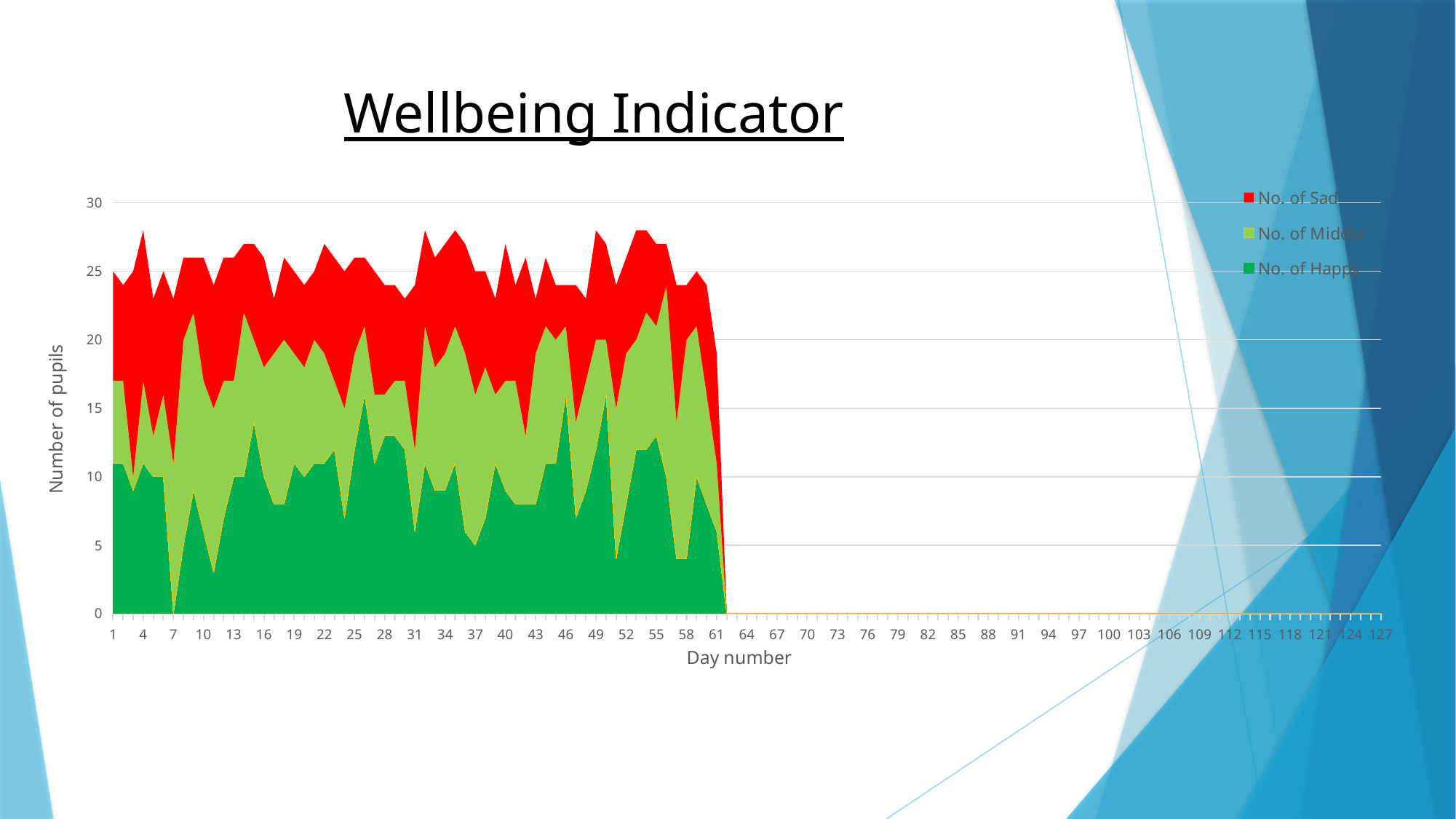
Which series is shown in red? No. of Sad Do the plotted values rise or fall after about day 61 along the x axis? fall Is the value for No. of Happy at day 7 greater or less than 5? less How many series does the legend list? 3 Is the stacked total of all three series at day 34 greater or less than 25? greater What is the label of the vertical axis? Number of pupils Is the stacked total of all three series at day 4 greater or less than 25? greater What is the last day number labelled on the x axis? 127 What kind of chart is shown on the slide? Stacked area chart